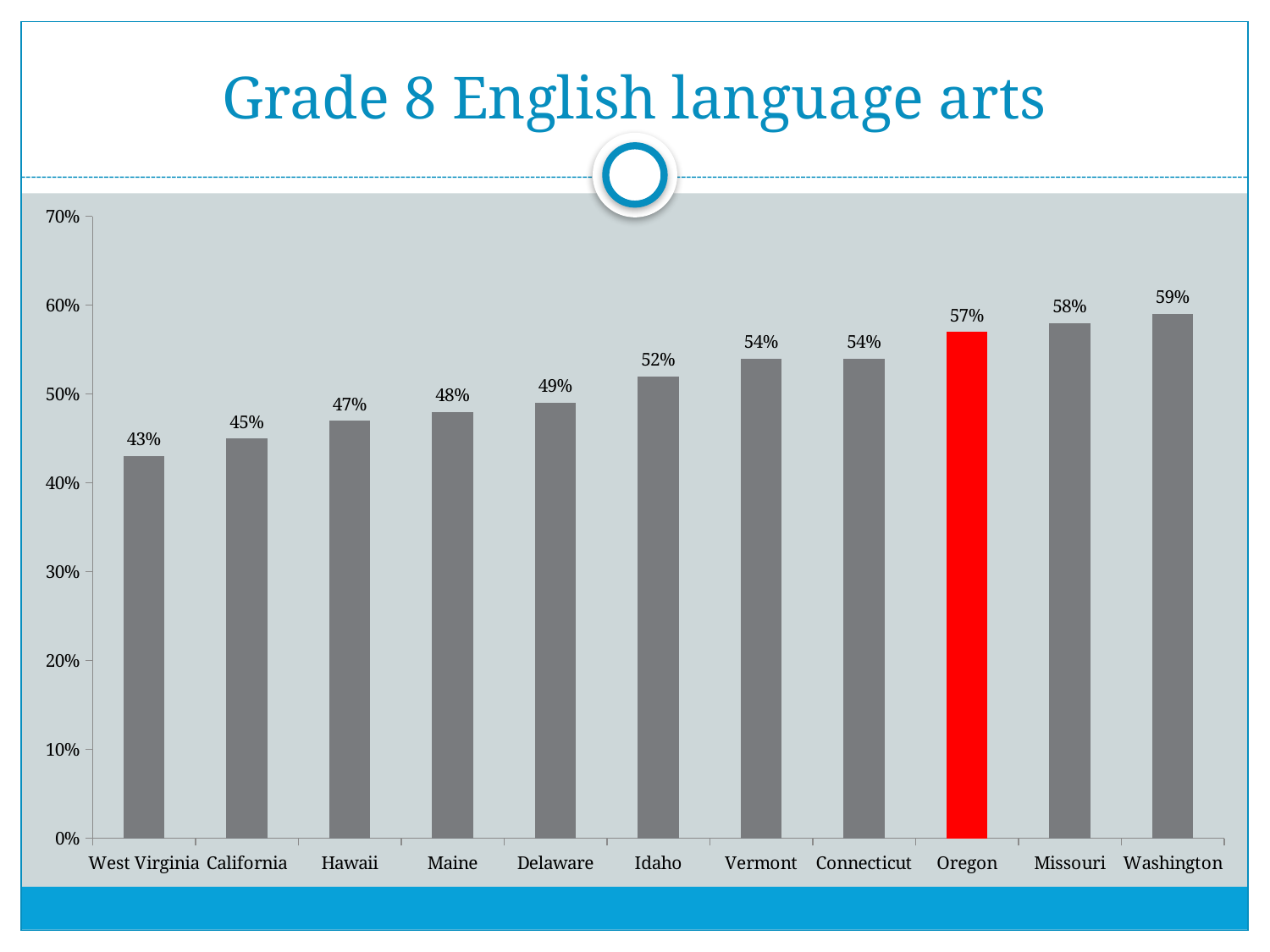
What is the value for Oregon? 57% Which state has the lowest value? West Virginia What kind of chart is shown on the slide? bar chart Which state's bar is coloured red? Oregon What is the difference between the values for Oregon and Maine? 9% What is the difference between the values for Washington and West Virginia? 16% What is the value for Idaho? 52% Which is larger, the value for Missouri or the value for Hawaii? Missouri Is the value for California greater or less than 50%? less How many states are shown on the chart? 11 What is the value for West Virginia? 43% Which state has the highest value? Washington